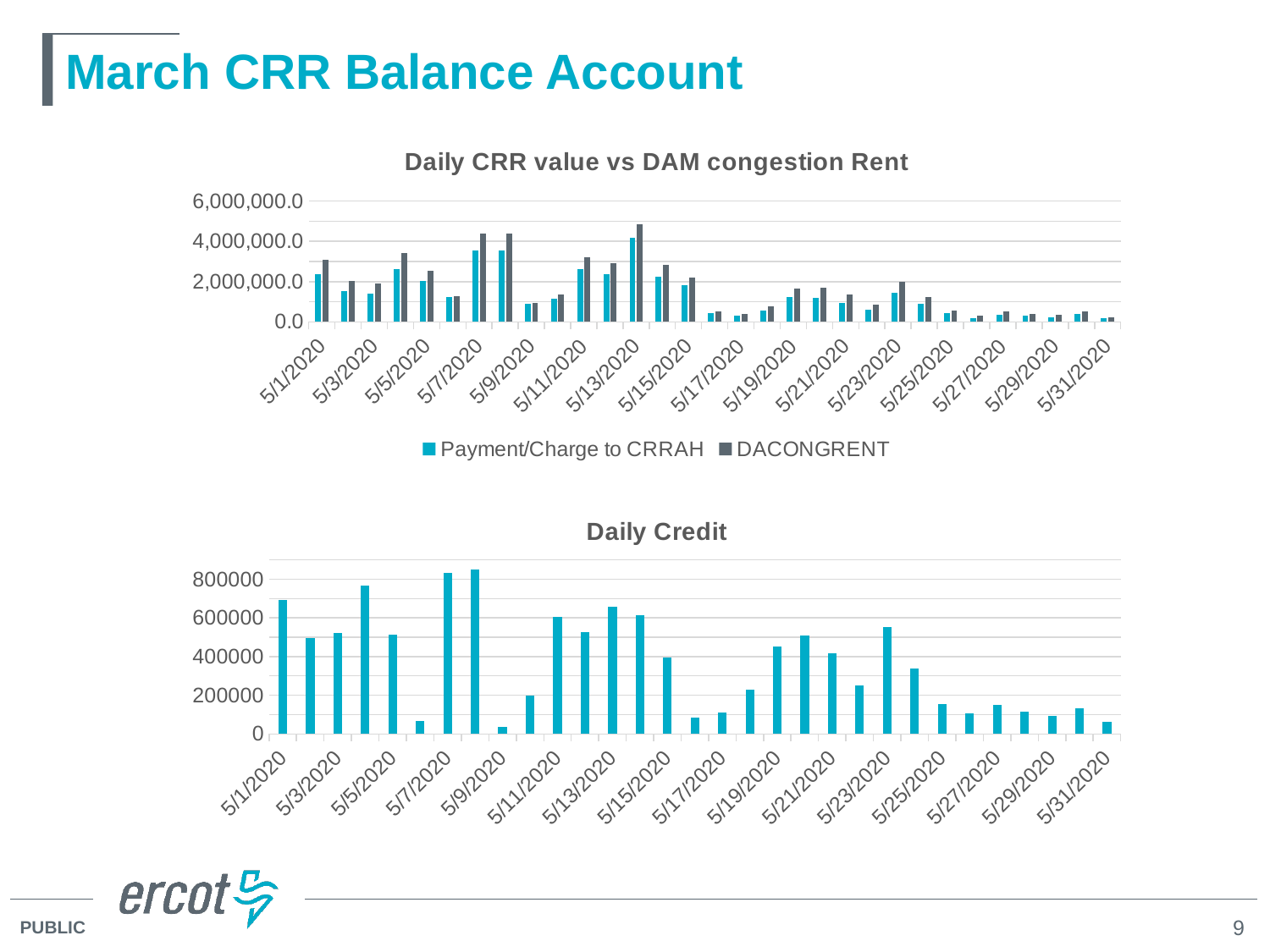
In the top chart 'Daily CRR value vs DAM congestion Rent', on which date is the DACONGRENT value highest? 5/13/2020 What kind of chart is the top chart titled 'Daily CRR value vs DAM congestion Rent'? bar chart In the top chart 'Daily CRR value vs DAM congestion Rent', is the Payment/Charge to CRRAH value on 5/1/2020 greater or less than 2,000,000.0? greater In the bottom chart 'Daily Credit', which date has the larger value, 5/1/2020 or 5/3/2020? 5/1/2020 In the bottom chart 'Daily Credit', is the value on 5/9/2020 greater or less than 200000? less In the top chart 'Daily CRR value vs DAM congestion Rent', is the DACONGRENT value on 5/13/2020 greater or less than 4,000,000.0? greater What are the two series named in the legend of the top chart 'Daily CRR value vs DAM congestion Rent'? Payment/Charge to CRRAH and DACONGRENT What kind of chart is the bottom chart titled 'Daily Credit'? bar chart In the bottom chart 'Daily Credit', do the values generally rise or fall from 5/1/2020 to 5/31/2020? fall In the top chart 'Daily CRR value vs DAM congestion Rent', on 5/1/2020 which is larger, Payment/Charge to CRRAH or DACONGRENT? DACONGRENT How many series does the legend of the top chart 'Daily CRR value vs DAM congestion Rent' list? 2